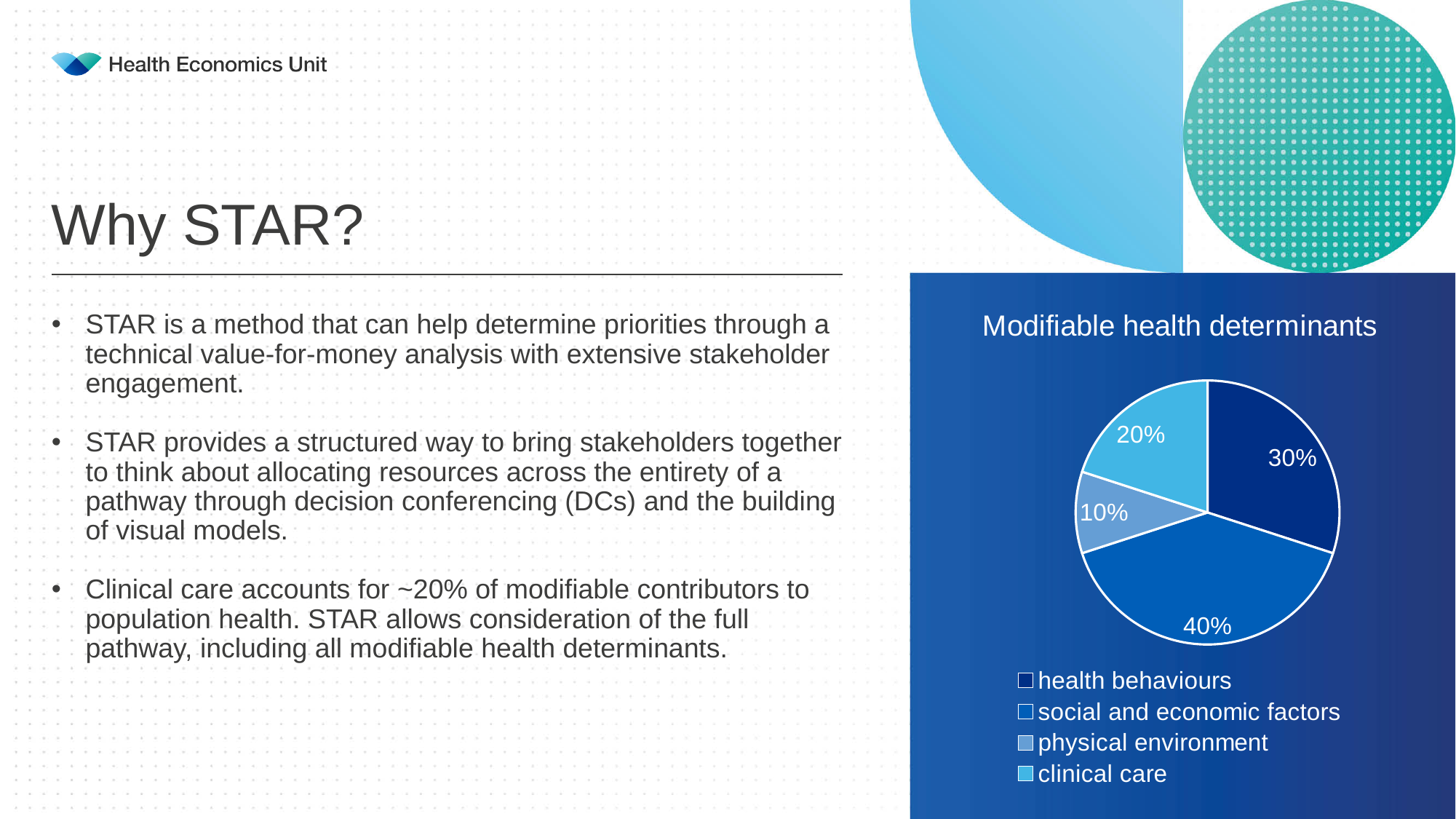
What share of the pie does physical environment account for? 10% What is the chart's title? Modifiable health determinants What is the combined share of health behaviours and clinical care? 50% Which is larger, the share for clinical care or the share for physical environment? clinical care What type of chart is shown under the title 'Modifiable health determinants'? pie chart What share of the pie does health behaviours account for? 30% What is the difference between the shares for social and economic factors and health behaviours? 10% Which category has the largest slice of the pie? social and economic factors Which category has the smallest slice of the pie? physical environment What share of the pie does clinical care account for? 20% How many categories does the legend list? 4 What share of the pie does social and economic factors account for? 40%